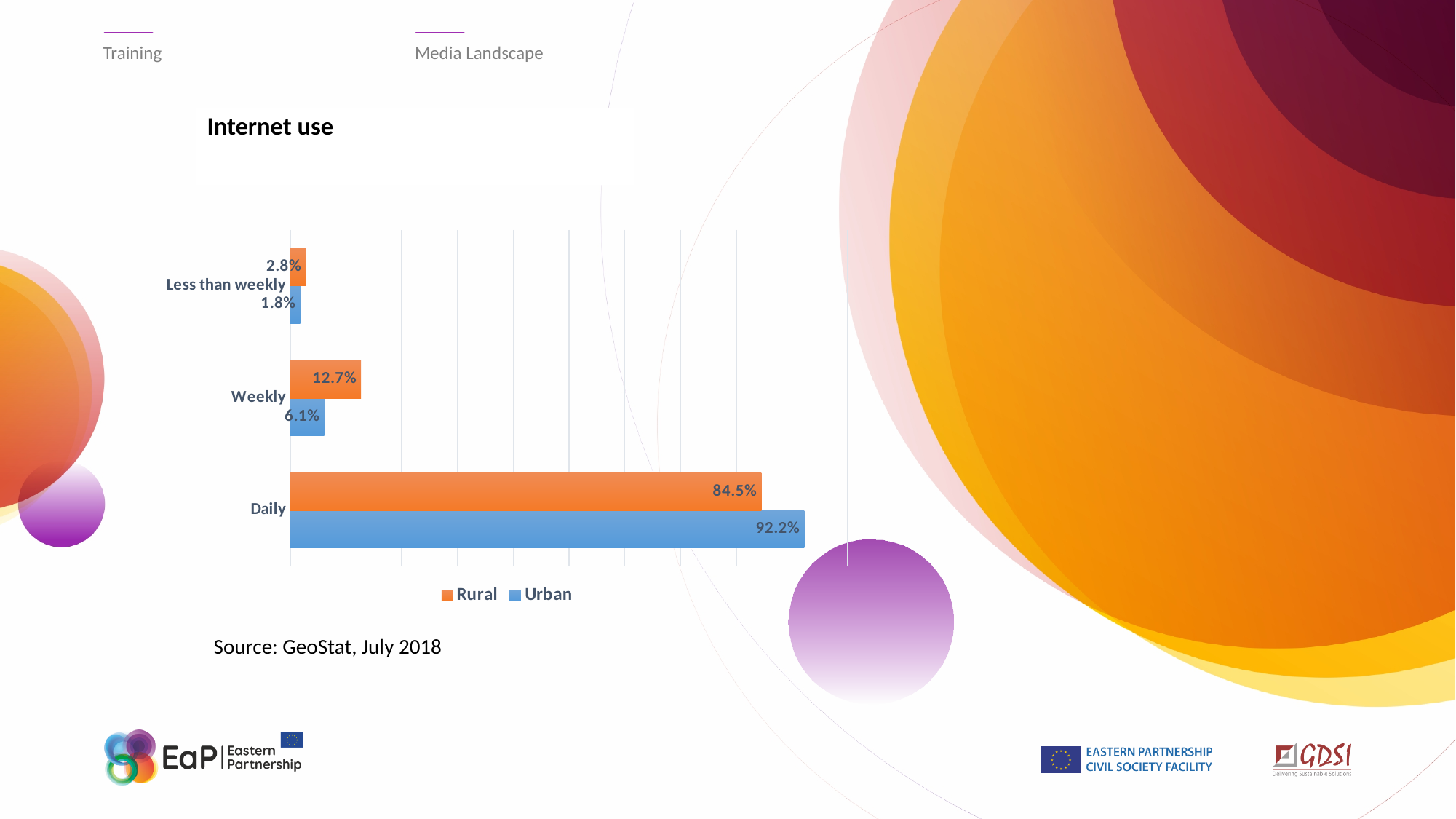
What is the Rural value for Daily internet use? 84.5% What is the Urban value for Weekly internet use? 6.1% Which category has the highest Urban value? Daily How many series does the legend list? 2 What is the Rural value for Less than weekly internet use? 2.8% What is the difference between the Rural and Urban values for Weekly internet use? 6.6% How many categories are shown on the chart? 3 What kind of chart is shown on the slide? Bar chart What is the difference between the Urban and Rural values for Daily internet use? 7.7% What is the Urban value for Daily internet use? 92.2% For Weekly internet use, which is larger, the Rural or the Urban value? Rural Which category has the lowest Rural value? Less than weekly